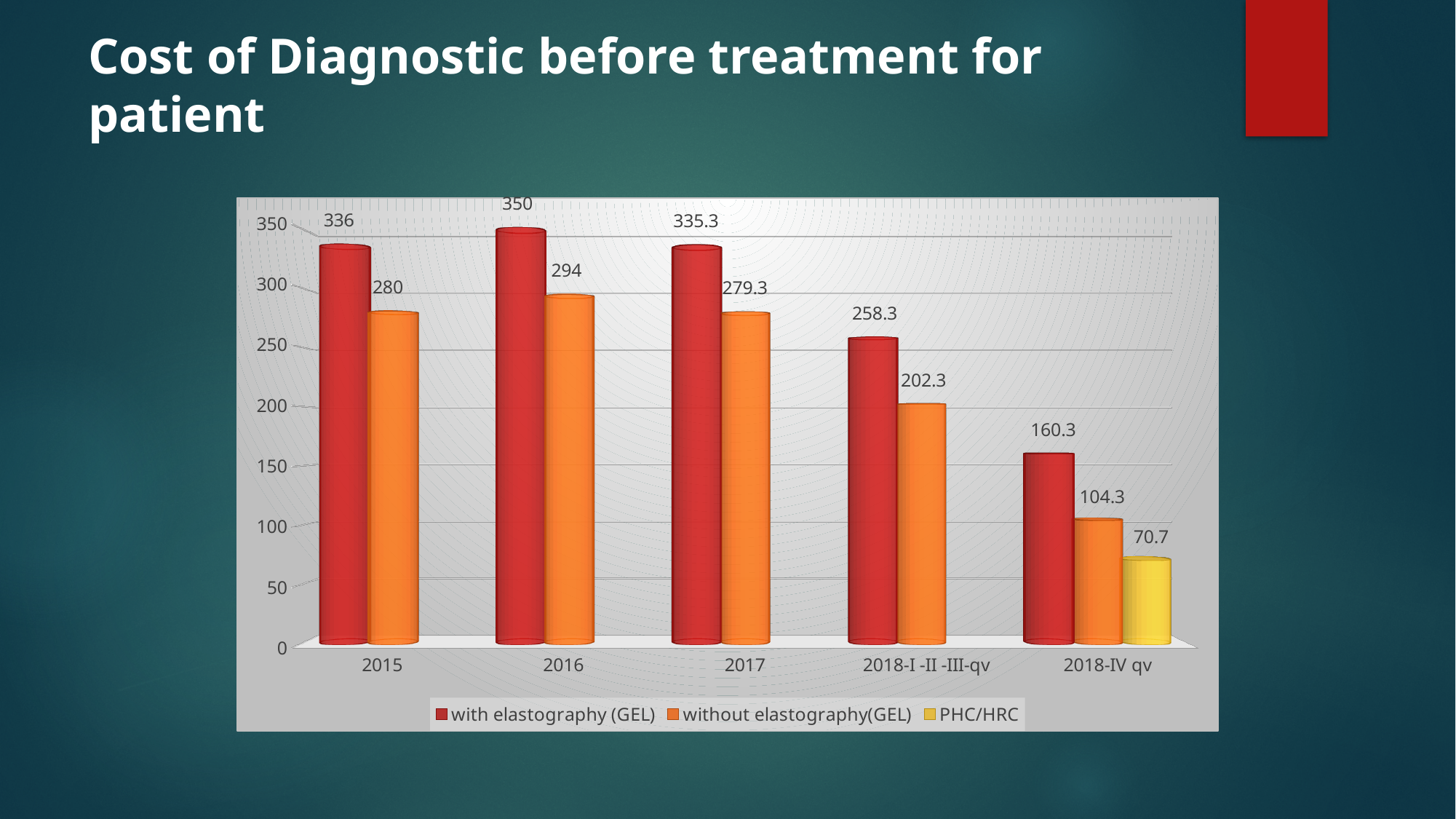
How many categories are shown on the x axis? 5 What is the value for 'with elastography (GEL)' in 2016? 350 What is the value for 'without elastography(GEL)' in 2018-I -II -III-qv? 202.3 What is the difference between the 'with elastography (GEL)' and 'without elastography(GEL)' values in 2015? 56 What kind of chart is shown on the slide? bar chart What is the title of the slide? Cost of Diagnostic before treatment for patient How many series does the legend list? 3 Which is larger: 'with elastography (GEL)' in 2017 or 'without elastography(GEL)' in 2016? with elastography (GEL) in 2017 In which category is the 'with elastography (GEL)' value highest? 2016 What is the value for PHC/HRC in 2018-IV qv? 70.7 Do the 'with elastography (GEL)' values rise or fall from 2016 to 2018-IV qv? fall In which category is the 'without elastography(GEL)' value lowest? 2018-IV qv